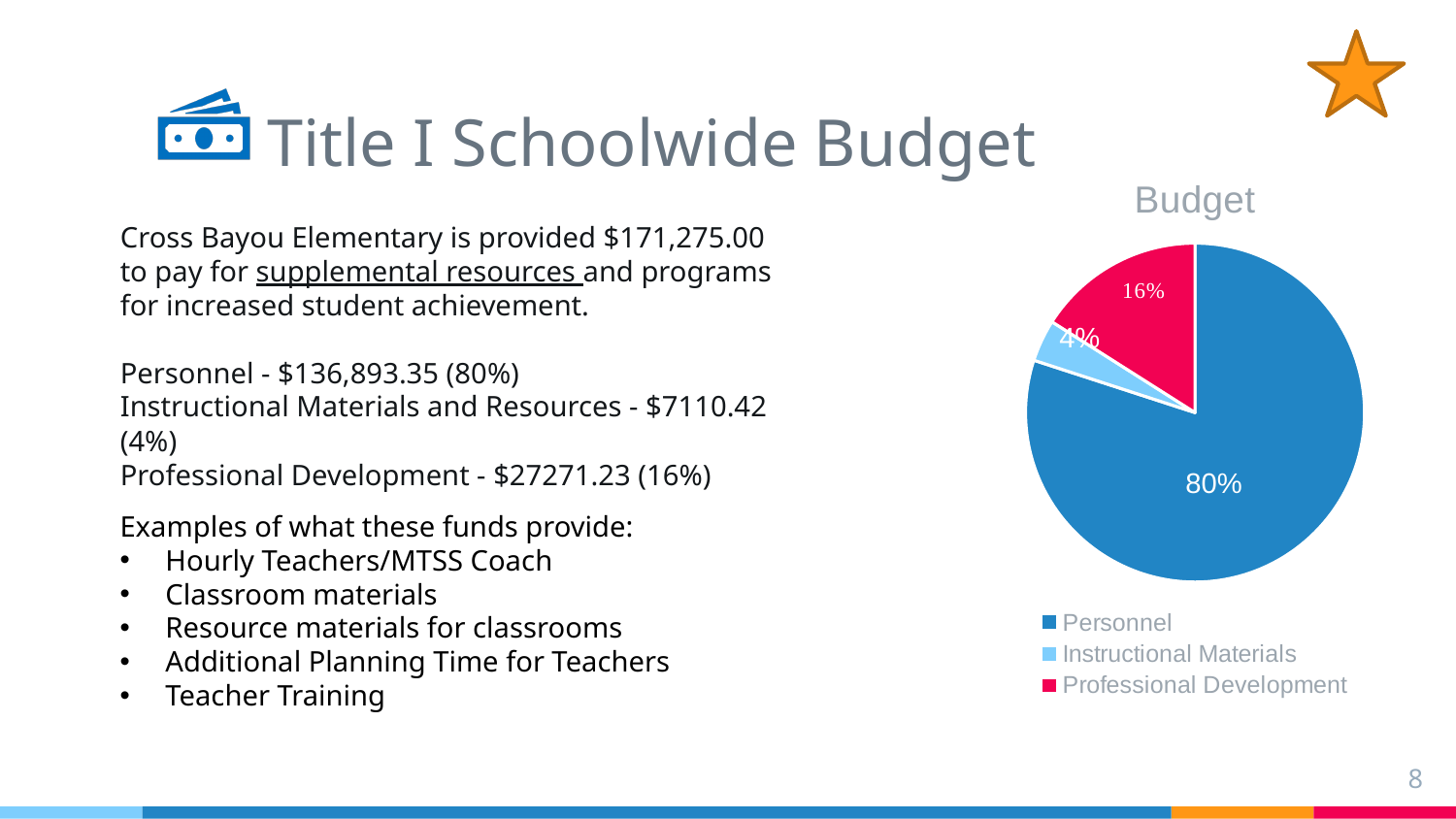
Which category has the largest slice of the pie? Personnel What colour is the Professional Development slice? red Which category has the smallest slice of the pie? Instructional Materials What share of the pie does Professional Development represent? 16% What share of the pie does Instructional Materials represent? 4% Which is larger, the Professional Development slice or the Instructional Materials slice? Professional Development What is the title of the chart? Budget How many entries does the legend list? 3 What is the difference in percentage points between the Personnel slice and the Professional Development slice? 64 What kind of chart is shown on the slide? pie chart What share of the pie does Personnel represent? 80% How many categories does the pie chart show? 3